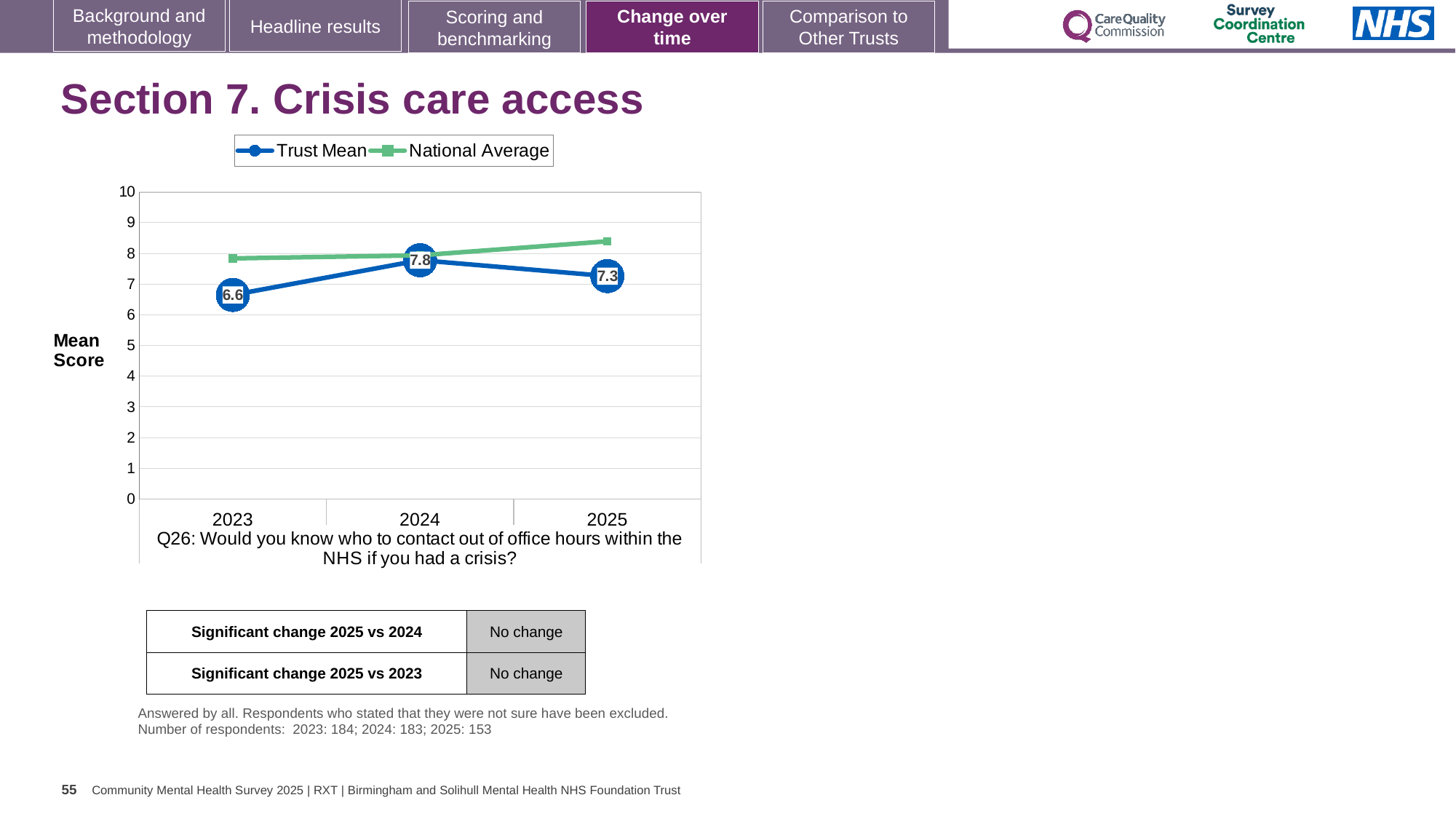
In 2025, which series is higher, Trust Mean or National Average? National Average Is the National Average value for 2025 greater or less than 8? greater What is the Trust Mean score for 2025? 7.3 What is the difference between the Trust Mean in 2024 and in 2025? 0.5 What is the Trust Mean score for 2023? 6.6 In which year is the Trust Mean highest? 2024 What type of chart is shown on the slide? Line chart What is the Trust Mean score for 2024? 7.8 By how much did the Trust Mean increase from 2023 to 2024? 1.2 Which year has the higher Trust Mean, 2023 or 2025? 2025 How many series does the legend list? 2 In which year is the Trust Mean lowest? 2023